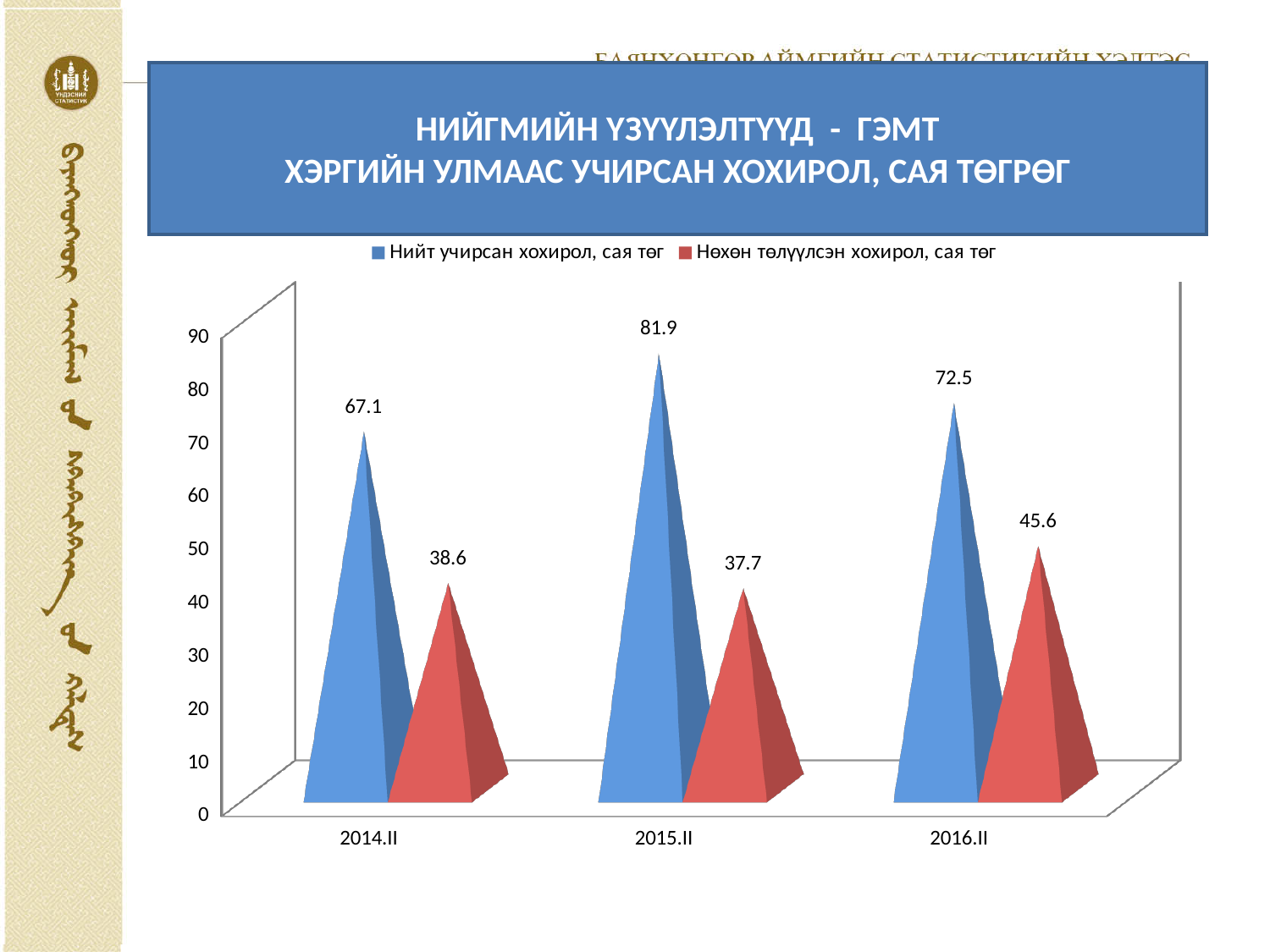
Which colour represents Нөхөн төлүүлсэн хохирол, сая төг in the legend? red What is the difference between Нийт учирсан хохирол and Нөхөн төлүүлсэн хохирол in 2016.II? 26.9 What kind of chart is shown on the slide? bar chart In which period is Нийт учирсан хохирол, сая төг highest? 2015.II What is the value of Нийт учирсан хохирол, сая төг for 2015.II? 81.9 How many periods are shown on the x axis? 3 Is the value of Нийт учирсан хохирол for 2016.II greater or less than 70? greater Which is larger: Нөхөн төлүүлсэн хохирол in 2014.II or in 2016.II? 2016.II What is the value of Нөхөн төлүүлсэн хохирол, сая төг for 2016.II? 45.6 In which period is Нөхөн төлүүлсэн хохирол, сая төг lowest? 2015.II How many series does the legend list? 2 What is the value of Нийт учирсан хохирол, сая төг for 2014.II? 67.1